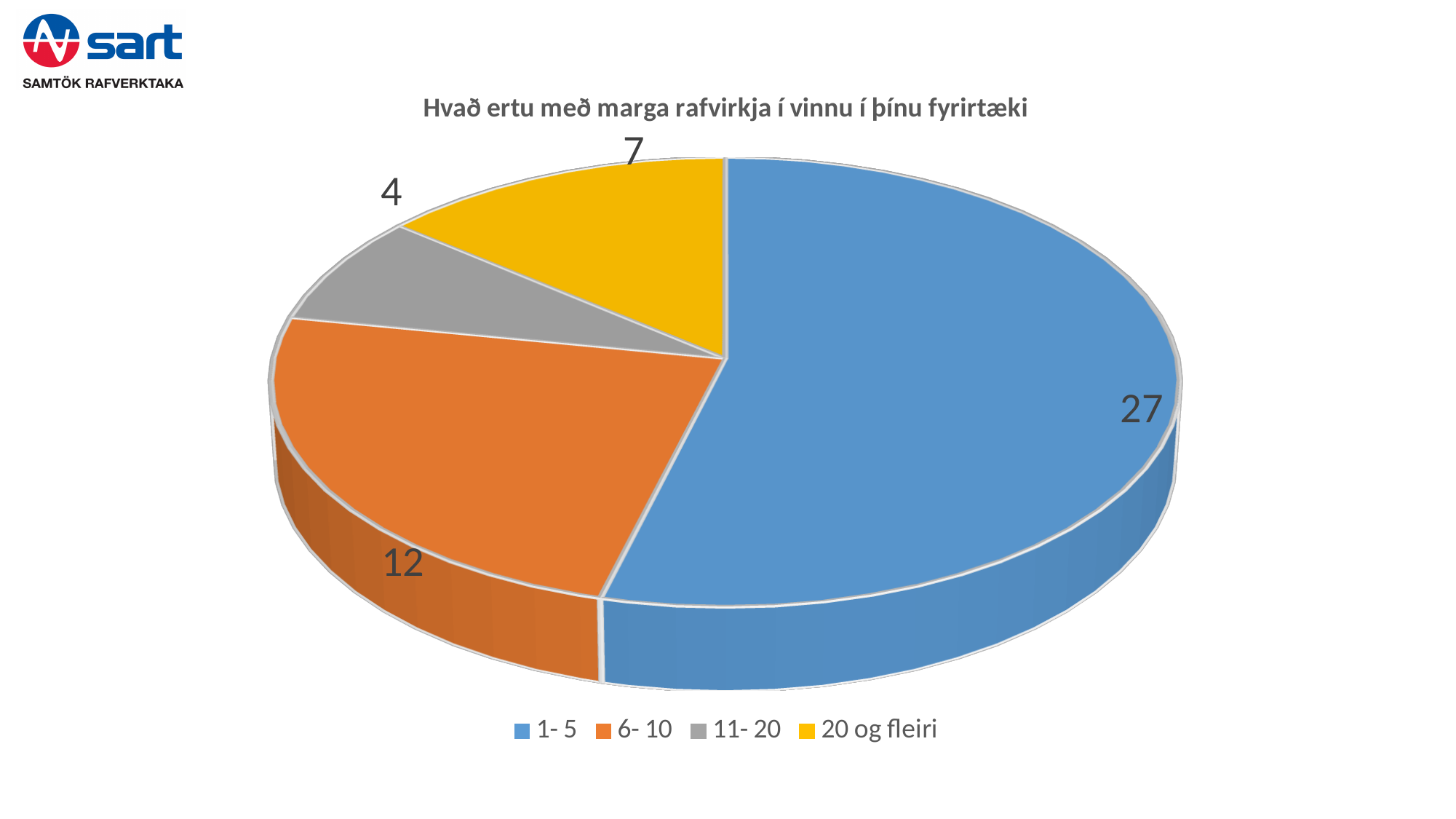
What share of the pie does the "1- 5" slice represent? 54% Which is larger, the value for "20 og fleiri" or the value for "11- 20"? 20 og fleiri Which category has the highest value? 1- 5 How many categories does the pie chart have? 4 What is the value for the "11- 20" category? 4 What is the difference between the values for "1- 5" and "6- 10"? 15 What is the value for the "6- 10" category? 12 Which category has the lowest value? 11- 20 What is the value for the "20 og fleiri" category? 7 What is the title of the chart? Hvað ertu með marga rafvirkja í vinnu í þínu fyrirtæki What is the value for the "1- 5" category? 27 What type of chart is shown on the slide? pie chart